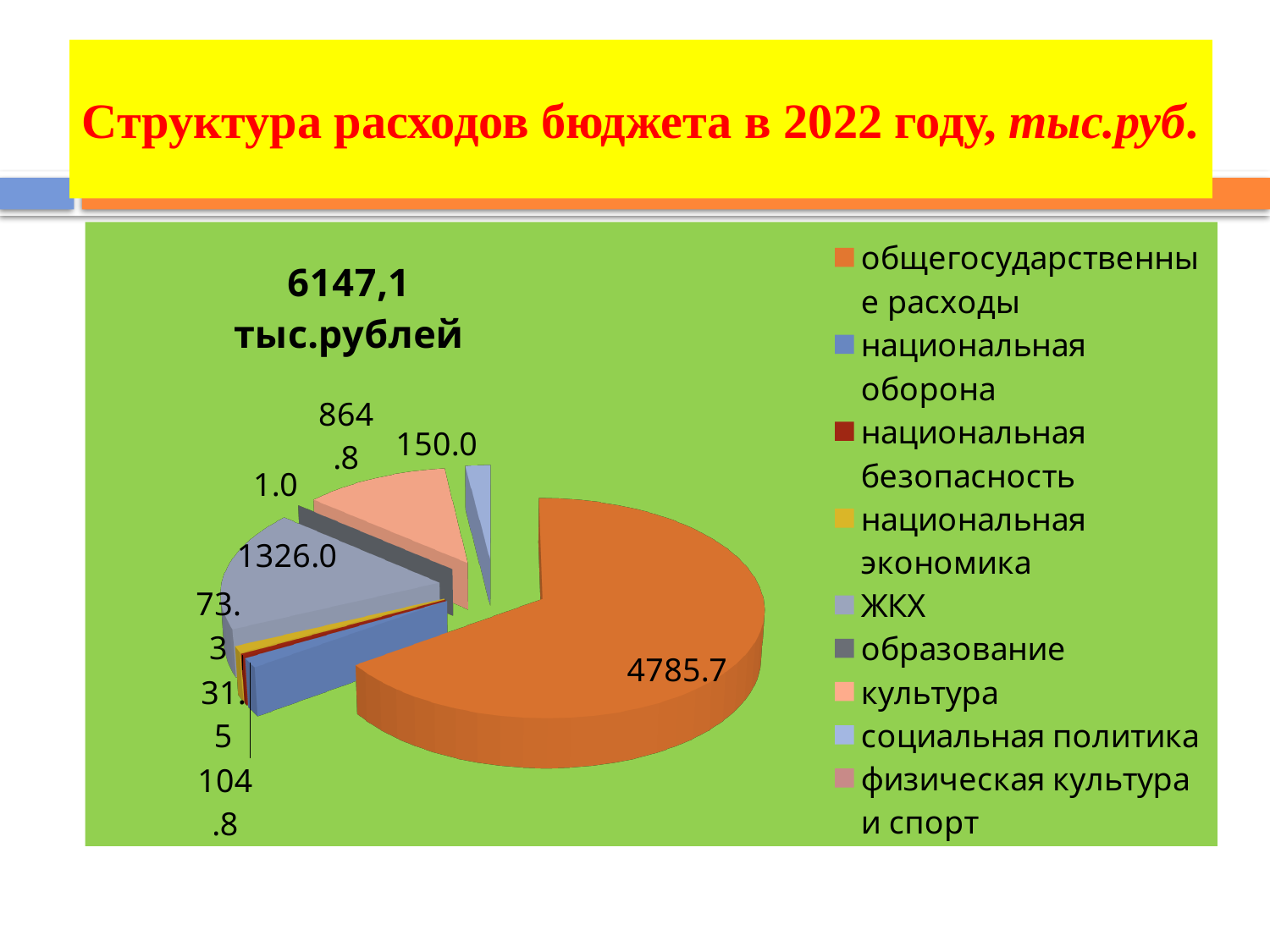
What kind of chart is shown on the slide? pie chart What is the value shown for социальная политика? 150.0 Which category has the largest slice of the pie? общегосударственные расходы What is the difference between the values for культура and социальная политика? 714.8 How many categories does the legend list? 9 What is the value shown for ЖКХ? 1326.0 What is the title of the slide? Структура расходов бюджета в 2022 году, тыс.руб. What is the value shown for общегосударственные расходы? 4785.7 What is the value shown for культура? 864.8 What total amount is printed above the pie chart? 6147,1 тыс.рублей Which is larger, the value for ЖКХ or the value for культура? ЖКХ What is the difference between the values for общегосударственные расходы and ЖКХ? 3459.7